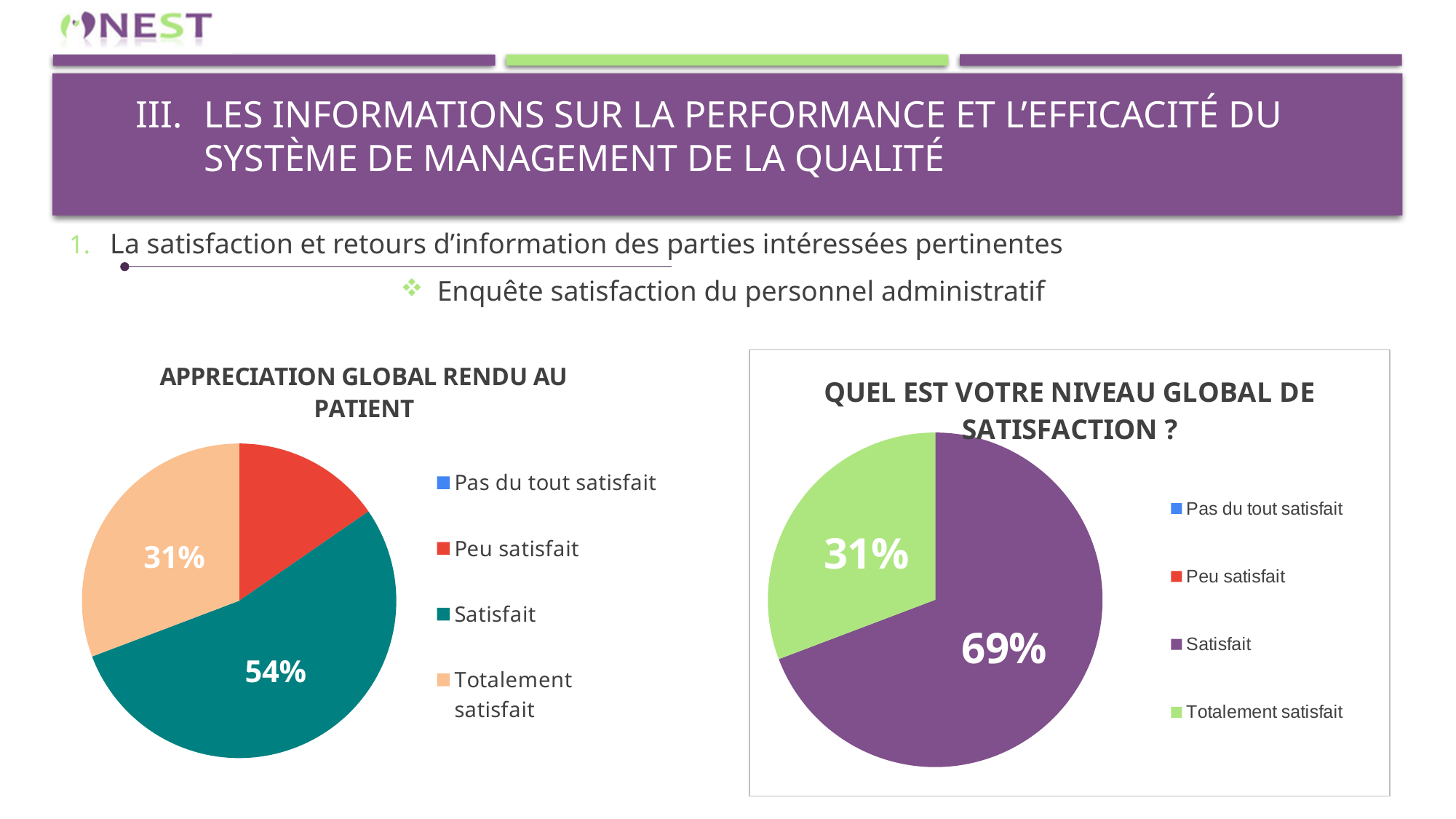
In the chart titled "QUEL EST VOTRE NIVEAU GLOBAL DE SATISFACTION ?", what share is labelled for Totalement satisfait? 31% In the chart titled "APPRECIATION GLOBAL RENDU AU PATIENT", what share is labelled for Totalement satisfait? 31% What type of chart is the one titled "QUEL EST VOTRE NIVEAU GLOBAL DE SATISFACTION ?"? Pie chart In the chart titled "APPRECIATION GLOBAL RENDU AU PATIENT", what is the difference between the Satisfait and Totalement satisfait shares? 23% In the chart titled "APPRECIATION GLOBAL RENDU AU PATIENT", which category has the largest slice? Satisfait In the chart titled "APPRECIATION GLOBAL RENDU AU PATIENT", what share is labelled for Satisfait? 54% In the chart titled "QUEL EST VOTRE NIVEAU GLOBAL DE SATISFACTION ?", what is the difference between the Satisfait and Totalement satisfait shares? 38% In the chart titled "QUEL EST VOTRE NIVEAU GLOBAL DE SATISFACTION ?", what share is labelled for Satisfait? 69% How many entries does the legend of the chart titled "APPRECIATION GLOBAL RENDU AU PATIENT" list? 4 In the chart titled "QUEL EST VOTRE NIVEAU GLOBAL DE SATISFACTION ?", which category has the largest slice? Satisfait In the chart titled "QUEL EST VOTRE NIVEAU GLOBAL DE SATISFACTION ?", what colour is the Satisfait slice? Purple In the chart titled "APPRECIATION GLOBAL RENDU AU PATIENT", which is larger: Peu satisfait or Totalement satisfait? Totalement satisfait